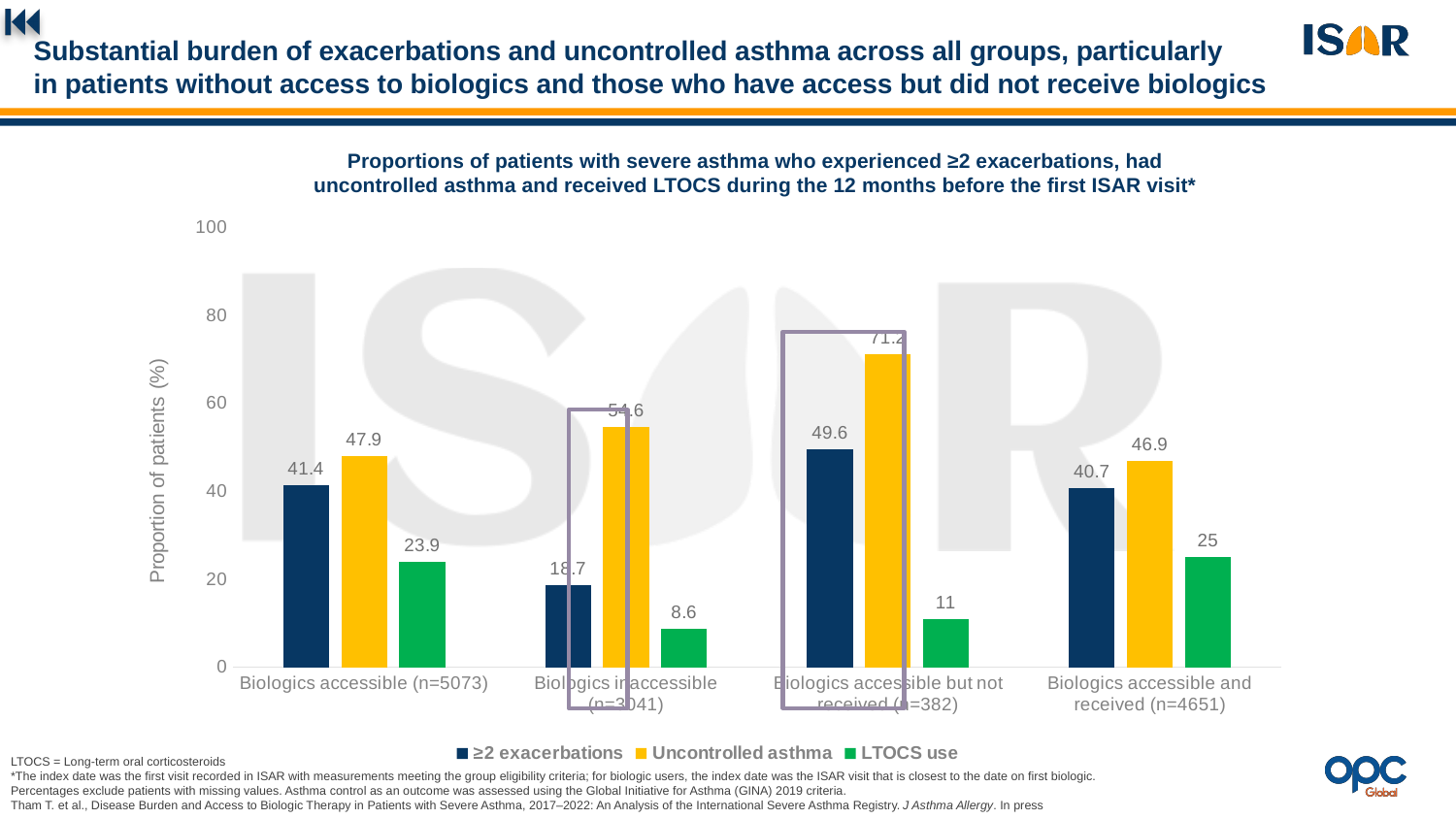
What type of chart is shown on the slide? Bar chart What is the LTOCS use value for the Biologics accessible but not received (n=382) group? 11 Is the ≥2 exacerbations value for the Biologics inaccessible (n=3041) group greater or less than 20? less What is the proportion of patients with ≥2 exacerbations in the Biologics accessible (n=5073) group? 41.4 Which is larger: LTOCS use in the Biologics accessible (n=5073) group or in the Biologics accessible and received (n=4651) group? Biologics accessible and received (n=4651) Which group has the lowest LTOCS use value? Biologics inaccessible (n=3041) How many series does the legend list? 3 What is the difference between the uncontrolled asthma value and the ≥2 exacerbations value in the Biologics accessible but not received (n=382) group? 21.6 What is the proportion of patients with uncontrolled asthma in the Biologics accessible and received (n=4651) group? 46.9 Which group has the highest proportion of patients with uncontrolled asthma? Biologics accessible but not received (n=382) What is the label of the y axis? Proportion of patients (%) How many patient groups (categories) are shown on the x axis? 4